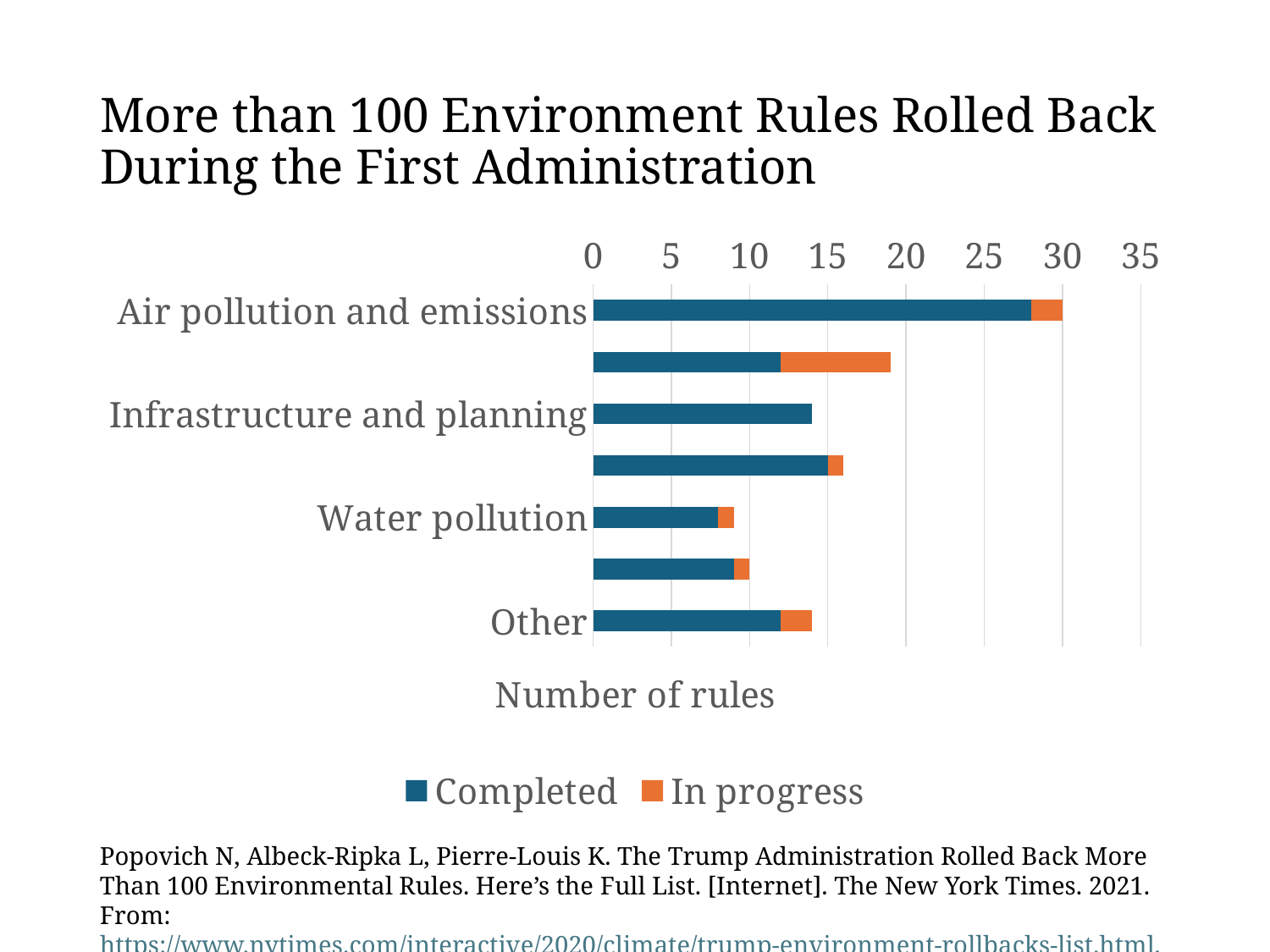
Is the total number of rules for Other greater or less than 10? greater Which has more rules in total, Air pollution and emissions or Other? Air pollution and emissions Is the total number of rules for Water pollution greater or less than 10? less How many series does the legend list? 2 Is the total number of rules for Air pollution and emissions greater or less than 25? greater What are the two series named in the legend? Completed and In progress Which category has the longest bar (the most rules in total)? Air pollution and emissions Which has more rules in total, Infrastructure and planning or Water pollution? Infrastructure and planning What kind of chart is shown on the slide? bar chart Among the labeled categories, which has the shortest bar? Water pollution Which labeled category has no In progress segment in its bar? Infrastructure and planning